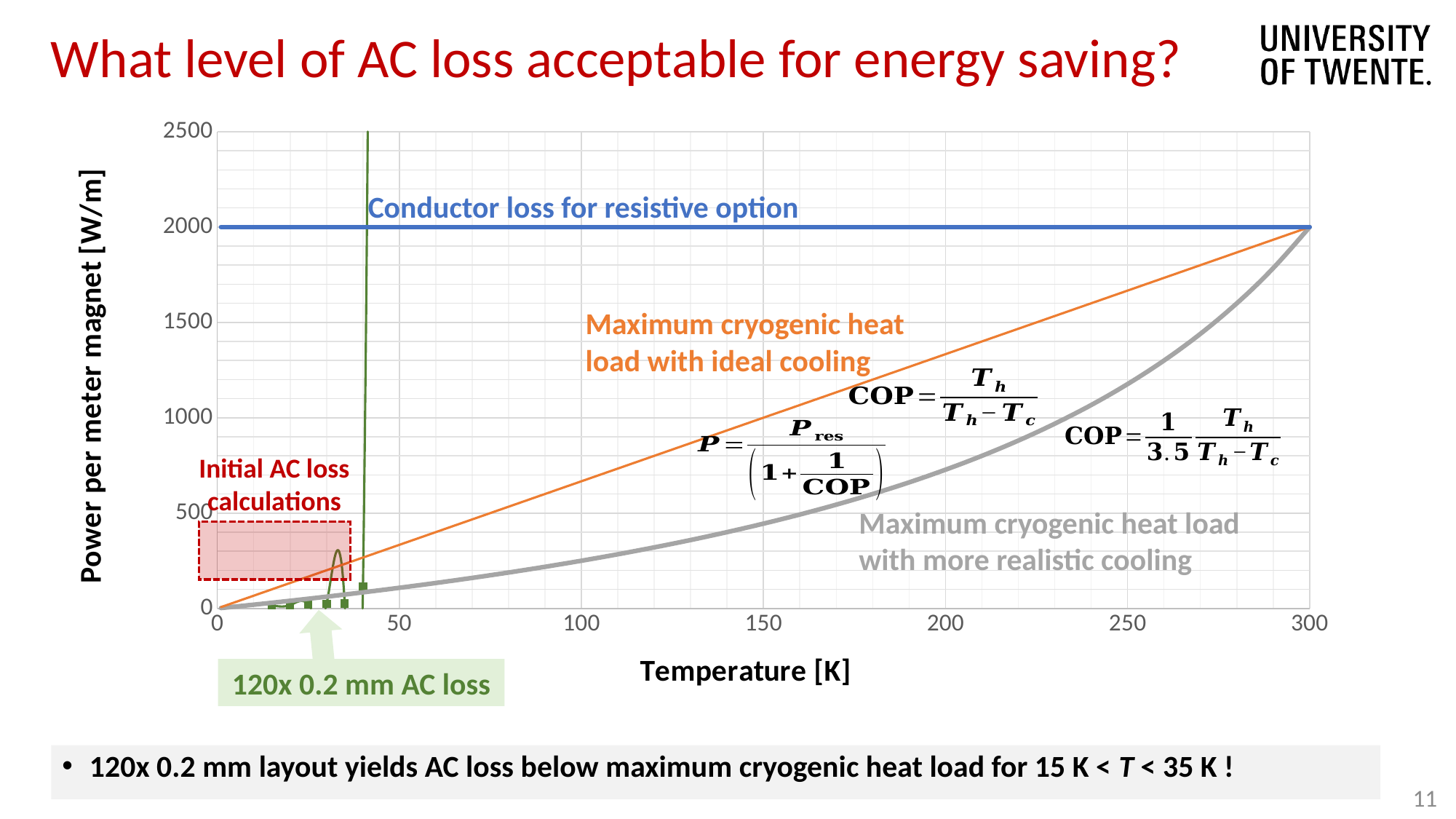
Is the value of the 'Maximum cryogenic heat load with more realistic cooling' curve at 250 K greater or less than 1000? greater Is the value of the 'Maximum cryogenic heat load with more realistic cooling' curve at 200 K greater or less than 1000? less Is the value of the 'Maximum cryogenic heat load with ideal cooling' line at 200 K greater or less than 1000? greater What is the label of the x axis? Temperature [K] What is the label of the y axis? Power per meter magnet [W/m] What is the maximum value shown on the y axis? 2500 What kind of chart is shown on the slide? line chart Does the 'Maximum cryogenic heat load with ideal cooling' line rise or fall as temperature increases? rise What is the value of the 'Conductor loss for resistive option' line in W/m? 2000 Which line has the highest value at 100 K? Conductor loss for resistive option At 150 K, which is larger: the 'Maximum cryogenic heat load with ideal cooling' line or the 'Maximum cryogenic heat load with more realistic cooling' curve? Maximum cryogenic heat load with ideal cooling